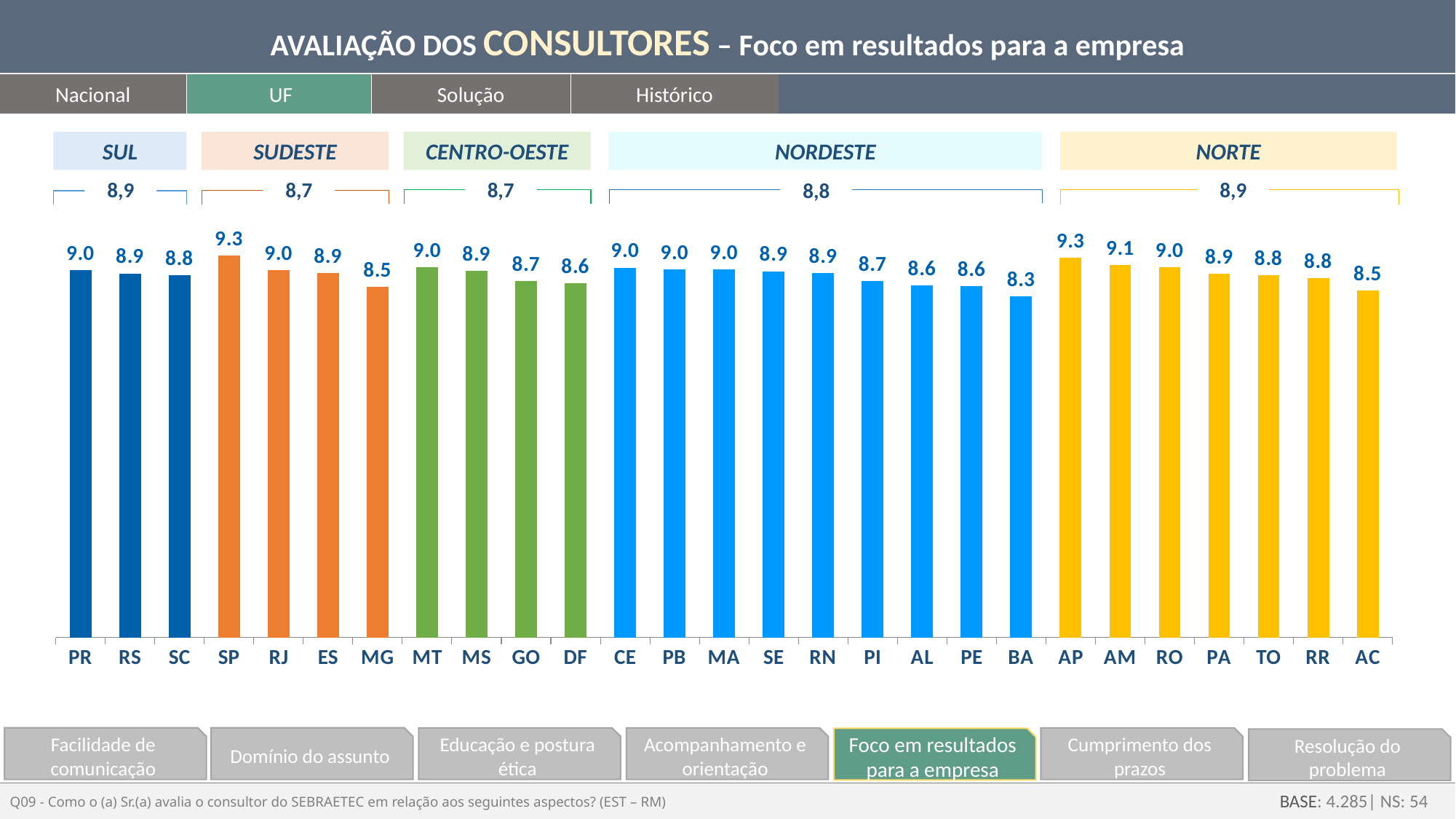
What is the value for MG? 8.5 Which has a larger value, AM or RO? AM How many states (bars) are shown in the chart? 27 What is the value for BA? 8.3 What is the difference between the values for AP and AC? 0.8 Within the NORTE group, which state has the highest value? AP How many states are shown in the NORDESTE group? 9 What is the value for AC? 8.5 What kind of chart is shown on the slide? Bar chart What is the regional value shown above the NORDESTE group? 8,8 Which state has the lowest value in the chart? BA What is the difference between the values for SP and MG? 0.8